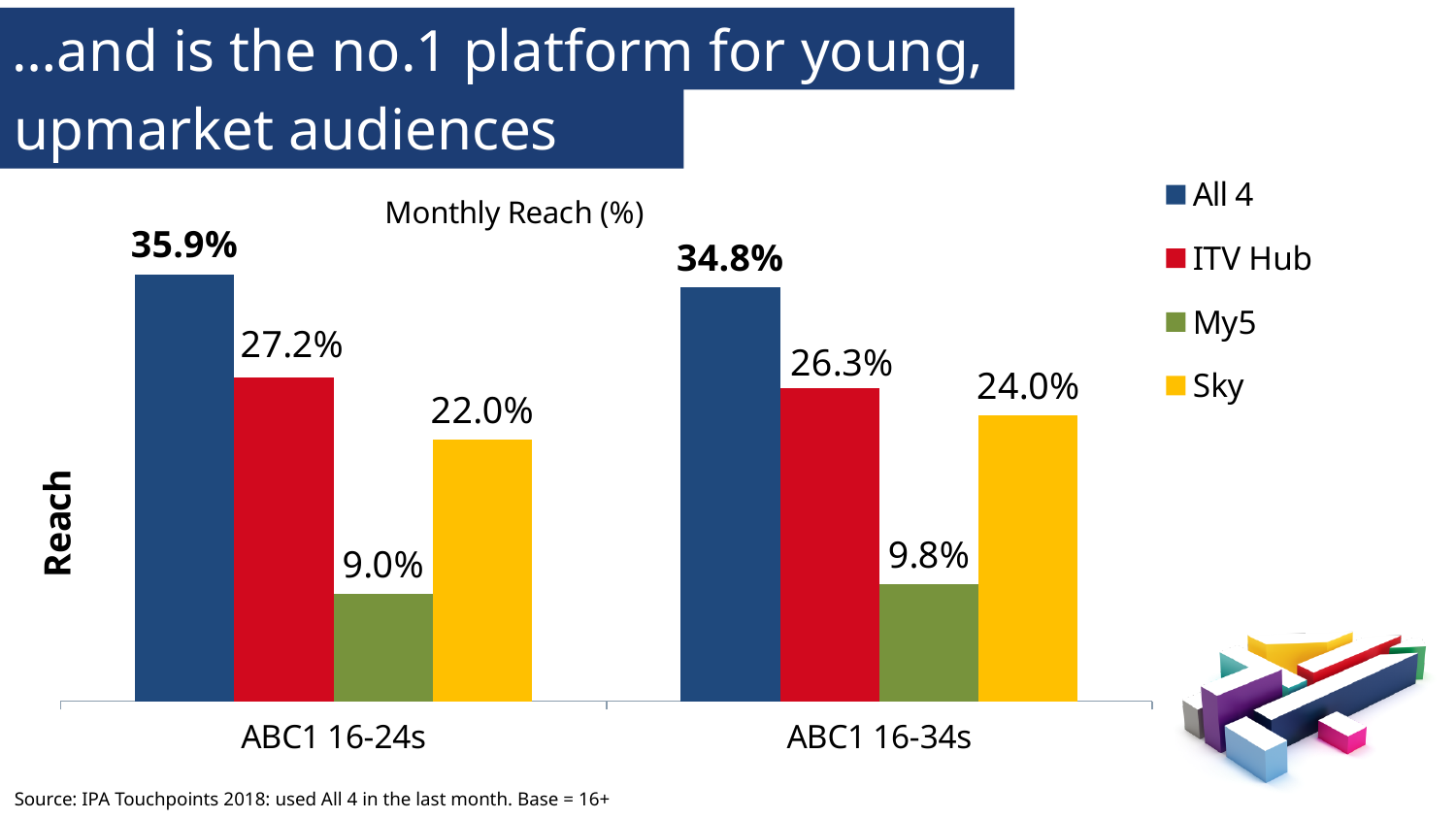
Which is larger: Sky's monthly reach among ABC1 16-24s or ITV Hub's monthly reach among ABC1 16-24s? ITV Hub How many audience categories are shown on the x axis? 2 What is the difference in monthly reach between All 4 and ITV Hub among ABC1 16-24s? 8.7% Which platform has the lowest monthly reach among ABC1 16-24s? My5 What is the monthly reach for Sky among ABC1 16-34s? 24.0% Which platform has the highest monthly reach among ABC1 16-34s? All 4 What is the monthly reach for My5 among ABC1 16-24s? 9.0% What kind of chart is shown on the slide? Bar chart What is the title of the chart? Monthly Reach (%) How many series does the legend list? 4 What is the monthly reach for ITV Hub among ABC1 16-34s? 26.3% What is the monthly reach for All 4 among ABC1 16-24s? 35.9%